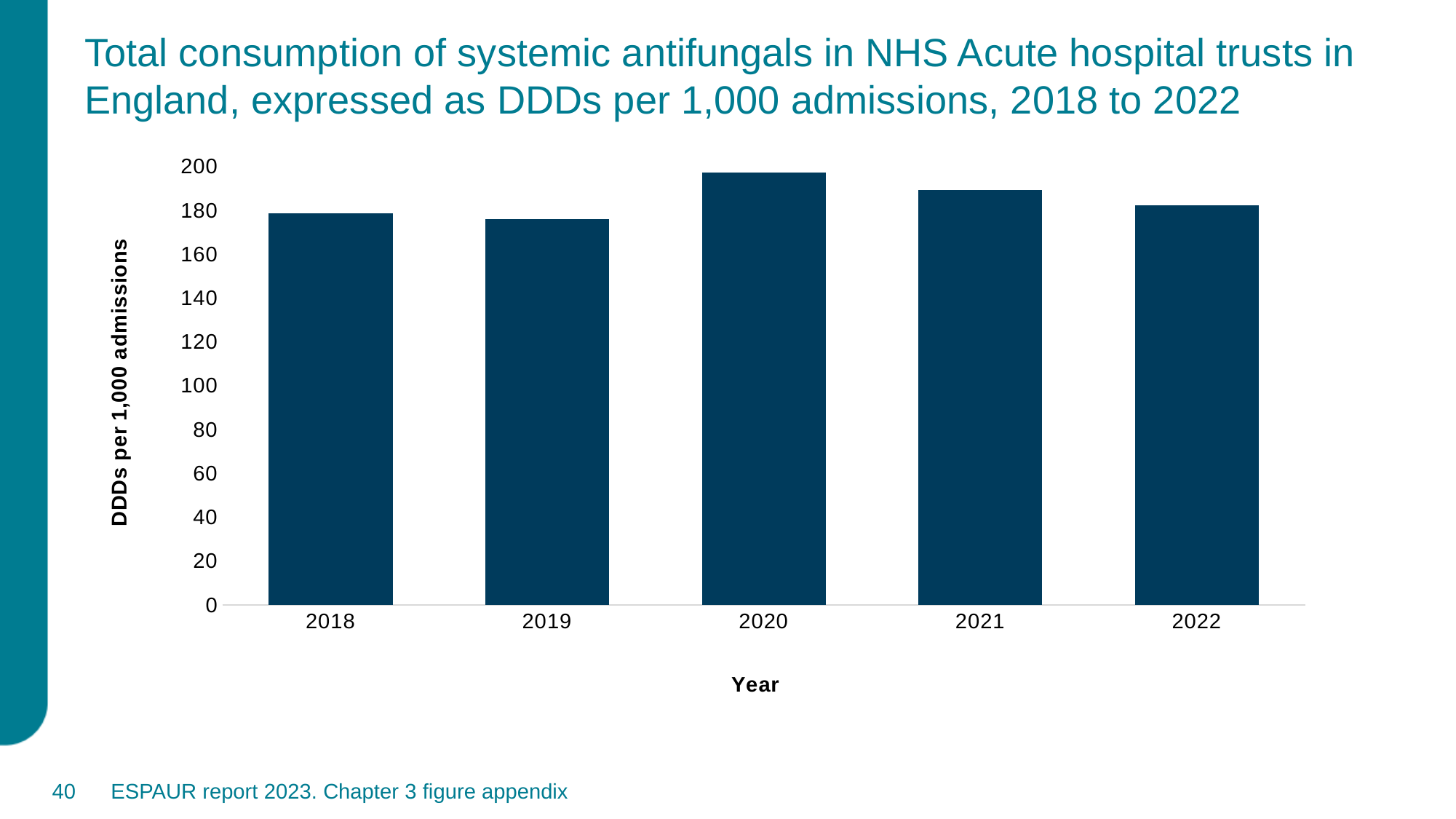
Which year has the highest consumption of systemic antifungals? 2020 Is the value for 2019 greater or less than 180? less Is the value for 2022 greater or less than 160? greater Which is larger, the value for 2020 or the value for 2021? 2020 Is the value for 2021 greater or less than 180? greater How many years are plotted on the x axis? 5 From 2020 to 2022, do the values rise or fall? fall What kind of chart is shown on the slide? bar chart Which is larger, the value for 2021 or the value for 2022? 2021 What is the label on the y axis? DDDs per 1,000 admissions